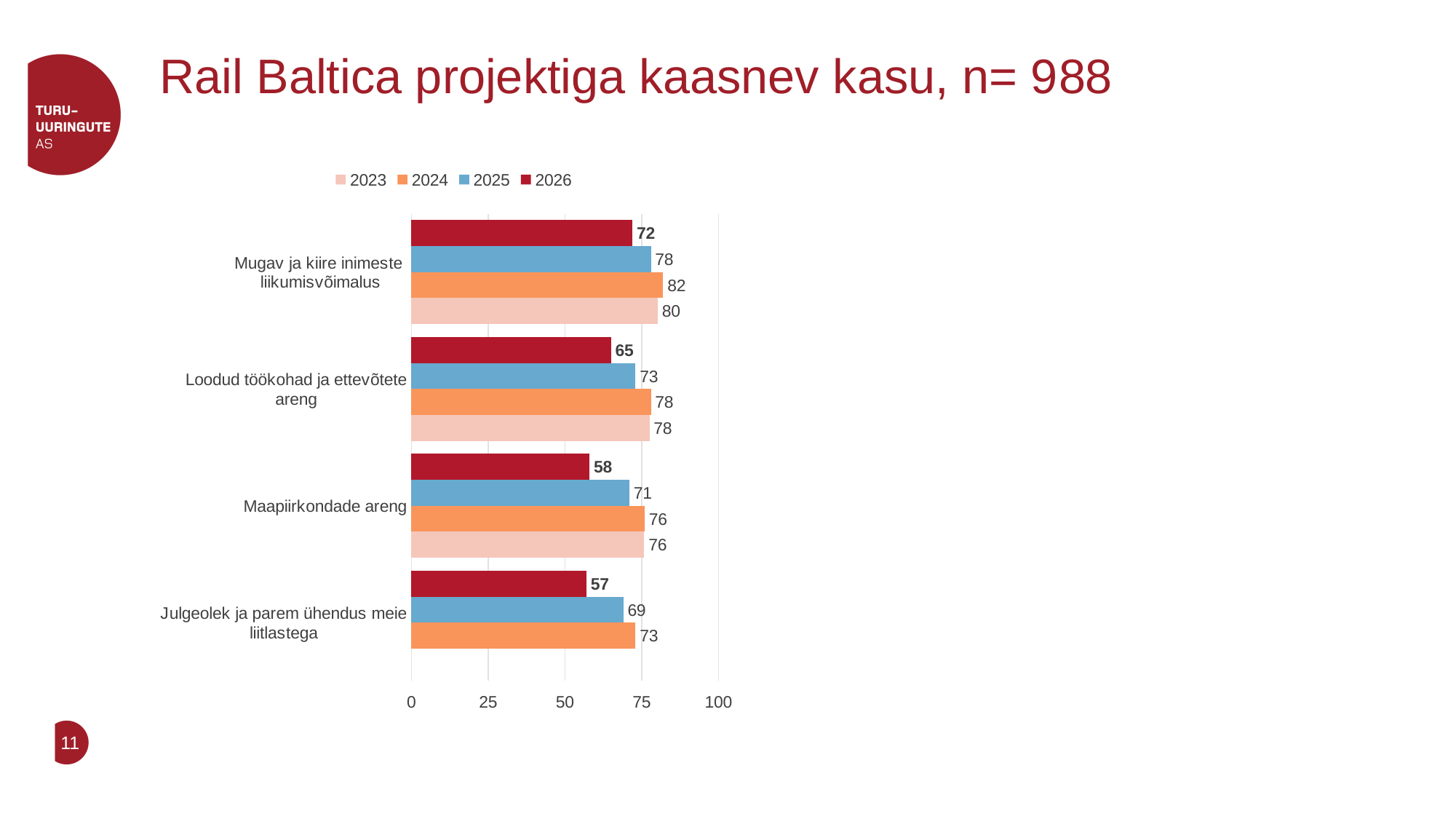
What is the difference between the 2024 and 2026 values for "Maapiirkondade areng"? 18 What is the 2023 value for "Loodud töökohad ja ettevõtete areng"? 78 Which category has the highest 2026 value? Mugav ja kiire inimeste liikumisvõimalus What kind of chart is shown on the slide? Bar chart What is the 2026 value for "Mugav ja kiire inimeste liikumisvõimalus"? 72 What is the 2024 value for "Maapiirkondade areng"? 76 Which is larger for "Loodud töökohad ja ettevõtete areng": the 2025 value or the 2026 value? 2025 What is the 2025 value for "Julgeolek ja parem ühendus meie liitlastega"? 69 How many categories are shown on the chart? 4 Which category has the lowest 2026 value? Julgeolek ja parem ühendus meie liitlastega Which series is shown in dark red in the legend? 2026 How many series does the legend list? 4